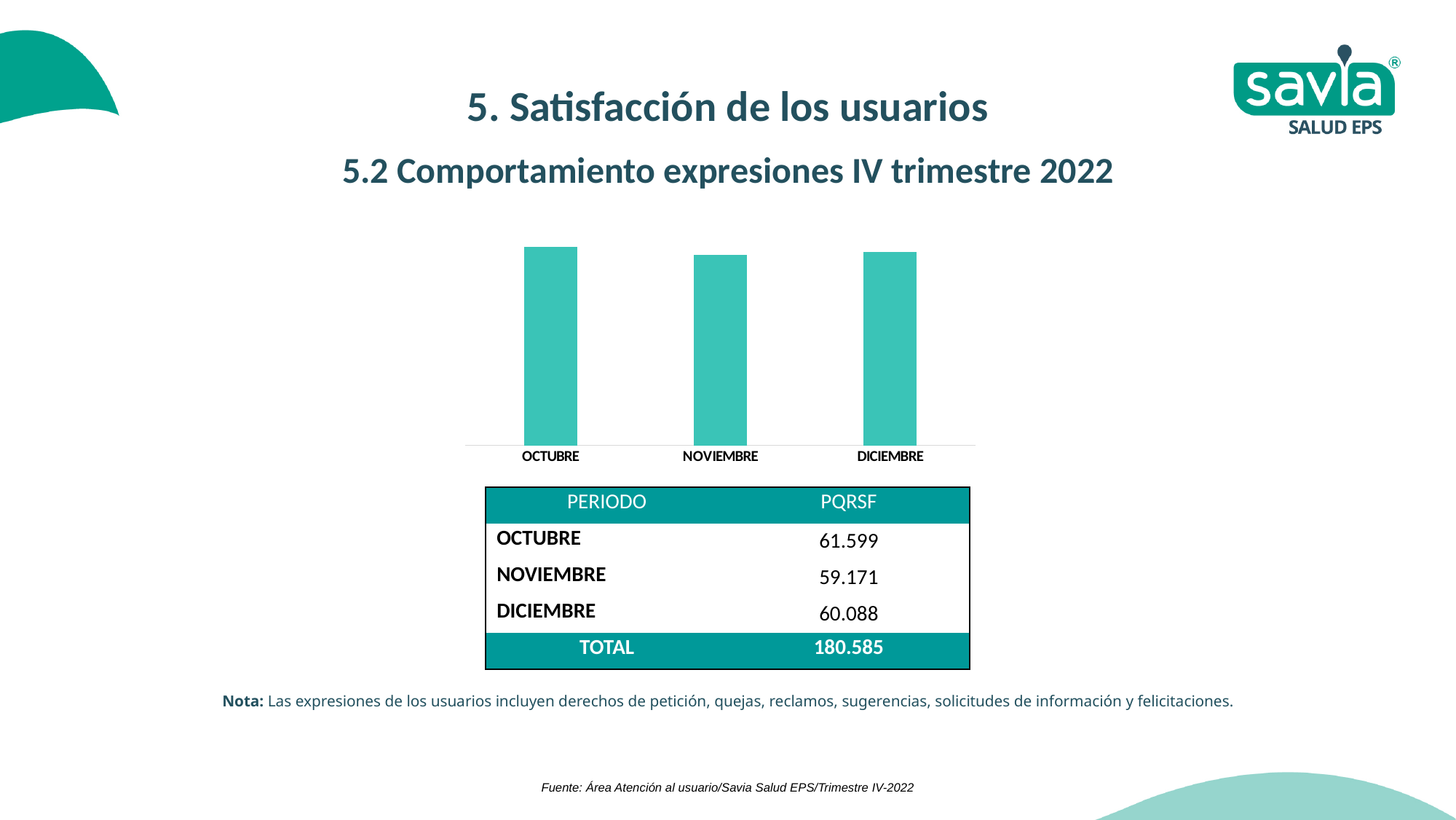
What kind of chart is shown on the slide? bar chart Which is larger, the PQRSF value for OCTUBRE or for DICIEMBRE? OCTUBRE Which month has the highest PQRSF value? OCTUBRE What is the difference between the PQRSF values for DICIEMBRE and NOVIEMBRE? 917 What is the PQRSF value for DICIEMBRE? 60.088 What is the PQRSF value for OCTUBRE? 61.599 What is the total PQRSF for the three months shown? 180.585 Which month has the lowest PQRSF value? NOVIEMBRE What is the difference between the PQRSF values for OCTUBRE and NOVIEMBRE? 2.428 What is the PQRSF value for NOVIEMBRE? 59.171 What are the category labels on the x axis of the chart, from left to right? OCTUBRE, NOVIEMBRE, DICIEMBRE How many bars does the chart have? 3